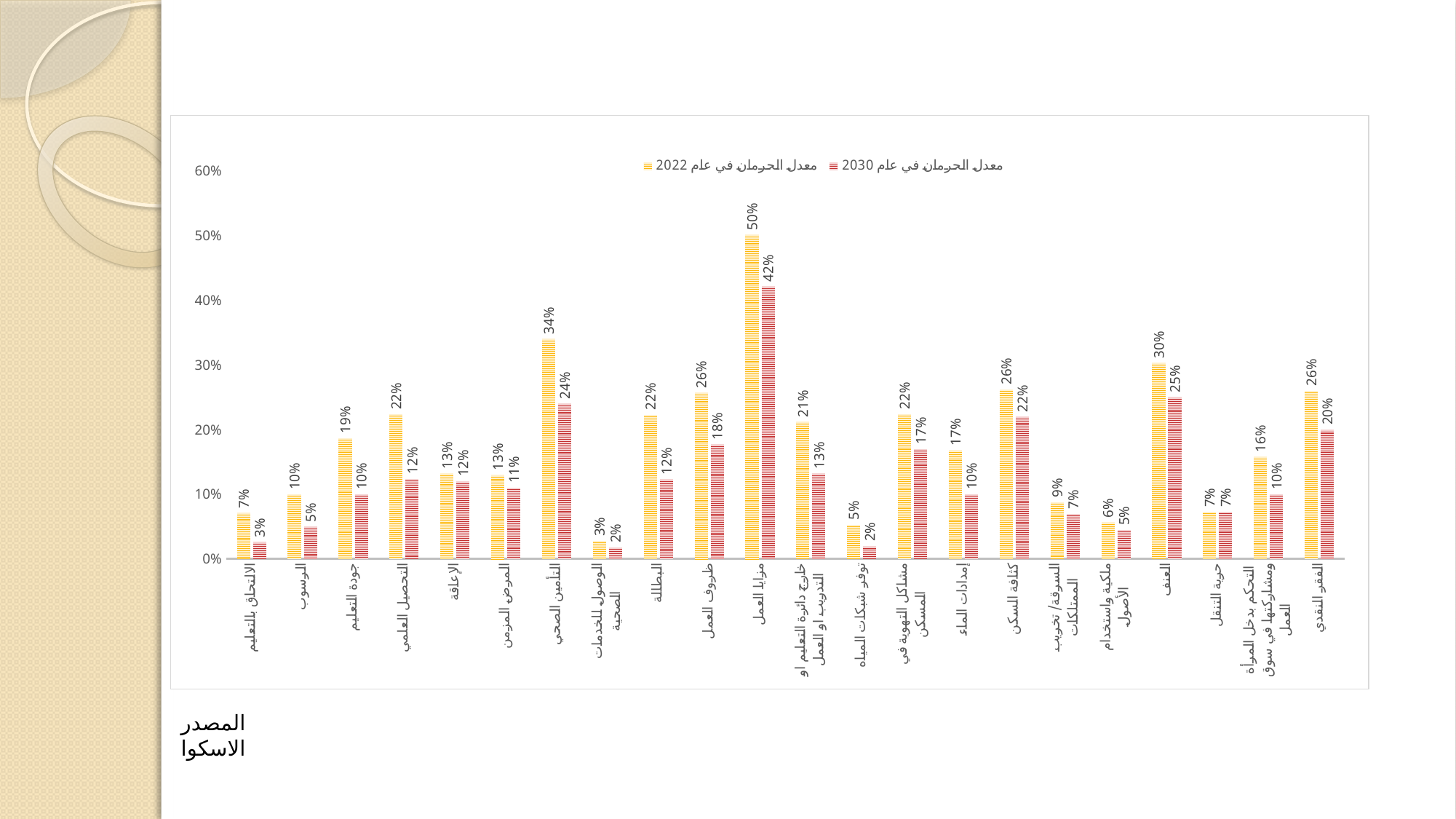
Which is larger for الفقر النقدي: the 2022 value or the 2030 value? the 2022 value What is the difference between the 2022 and 2030 values for العنف? 5% What is the difference between the 2022 and 2030 values for جودة التعليم? 9% Which category has the lowest value in the series معدل الحرمان في عام 2030? الوصول للخدمات الصحية and توفر شبكات المياه (both 2%) How many categories are shown on the x axis? 22 Which category has the highest value in the series معدل الحرمان في عام 2022? مزايا العمل What is the value for مزايا العمل in the series معدل الحرمان في عام 2022? 50% How many series does the legend list? 2 What type of chart is shown on the slide? bar chart What is the value for التأمين الصحي in the series معدل الحرمان في عام 2030? 24% What is the value for حرية التنقل in the series معدل الحرمان في عام 2022? 7% Which colour represents the series معدل الحرمان في عام 2030? red